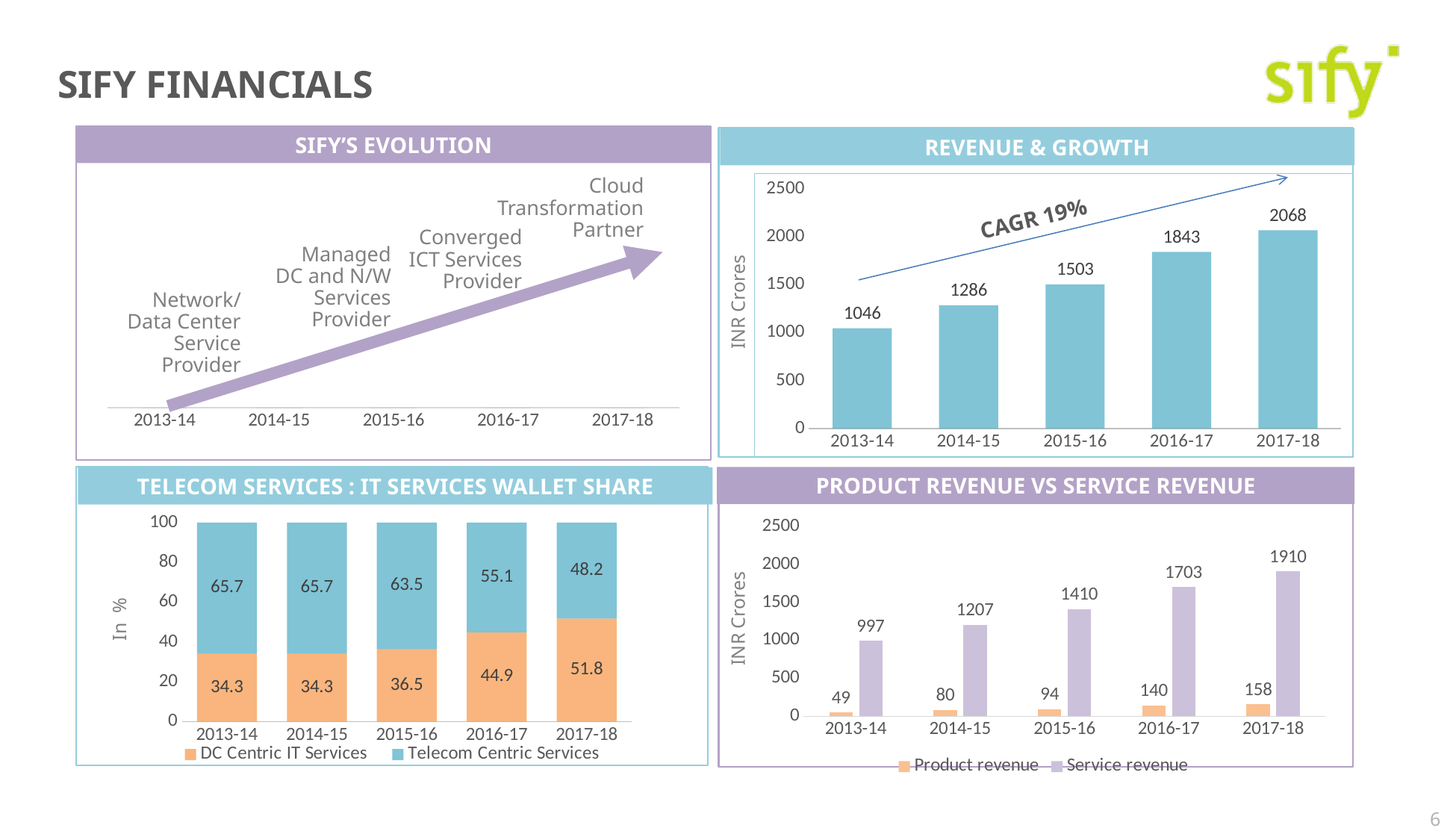
In the Product Revenue vs Service Revenue chart, which is larger in 2017-18, Product revenue or Service revenue? Service revenue In the Revenue & Growth chart, do the values rise or fall from 2013-14 to 2017-18? rise In the Revenue & Growth chart, what CAGR is shown on the arrow? CAGR 19% What kind of chart is the Product Revenue vs Service Revenue chart? bar chart In the Revenue & Growth chart, which year has the highest value? 2017-18 In the Telecom Services : IT Services Wallet Share chart, what is the value for DC Centric IT Services in 2016-17? 44.9 In the Telecom Services : IT Services Wallet Share chart, what is the value for Telecom Centric Services in 2017-18? 48.2 In the Product Revenue vs Service Revenue chart, what is the Product revenue for 2014-15? 80 In the Revenue & Growth chart, what is the difference between the 2017-18 and 2013-14 values? 1022 In the Telecom Services : IT Services Wallet Share chart, how many series does the legend list? 2 In the Revenue & Growth chart, what is the value for 2015-16? 1503 In the Telecom Services : IT Services Wallet Share chart, what is the total of the stacked bar for 2015-16? 100